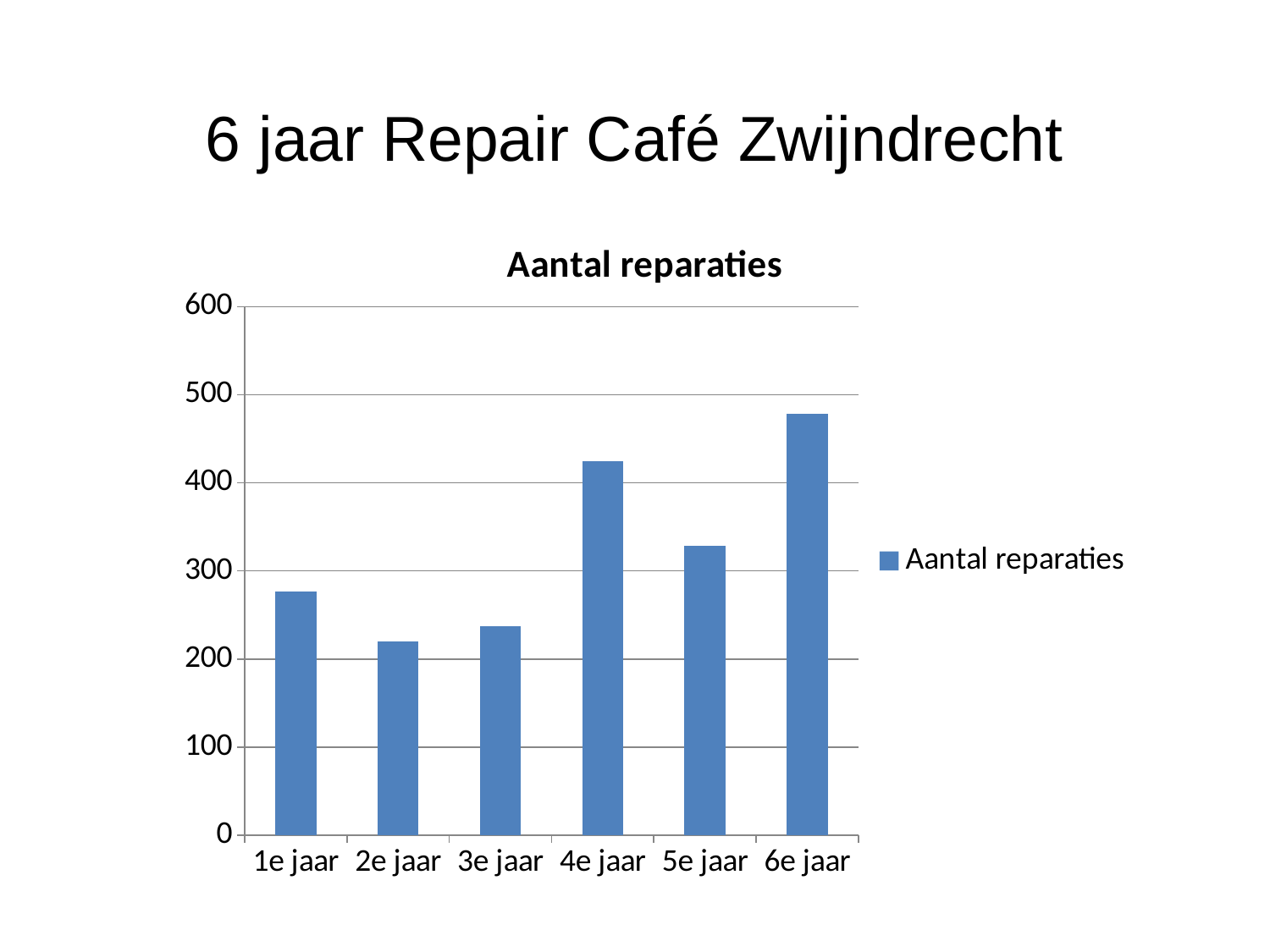
Which is larger, the value for 1e jaar or the value for 3e jaar? 1e jaar Which is larger, the value for 4e jaar or the value for 5e jaar? 4e jaar Which year has the highest number of reparaties? 6e jaar Which year has the lowest number of reparaties? 2e jaar What is the title of the chart? Aantal reparaties Is the value for 5e jaar greater or less than 300? greater How many categories are shown on the x axis of the chart? 6 Is the value for 1e jaar greater or less than 300? less Is the value for 4e jaar greater or less than 400? greater How many series does the legend list? 1 What type of chart is shown on the slide? bar chart